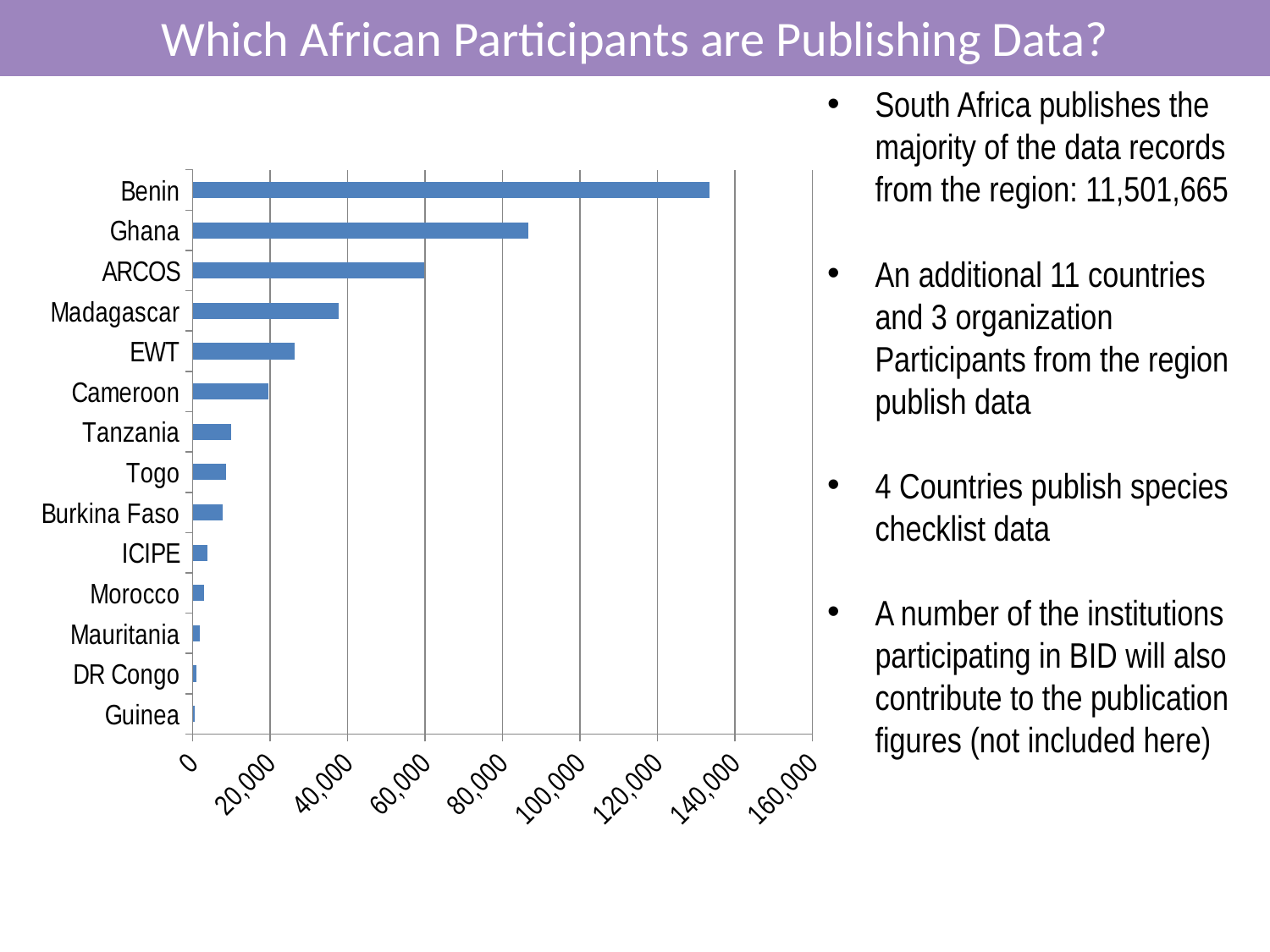
What colour are the bars in the chart? blue Is the value for Madagascar greater or less than 40,000? less Which participant has the highest value in the chart? Benin Which has a larger value, EWT or Togo? EWT What kind of chart is shown on the slide? bar chart Which participant has the lowest value in the chart? Guinea Do the bar values increase or decrease going from the top category to the bottom category? decrease Which has a larger value, Ghana or Madagascar? Ghana Is the value for Tanzania greater or less than 20,000? less Is the value for Ghana greater or less than 100,000? less How many participants (categories) are shown in the chart? 14